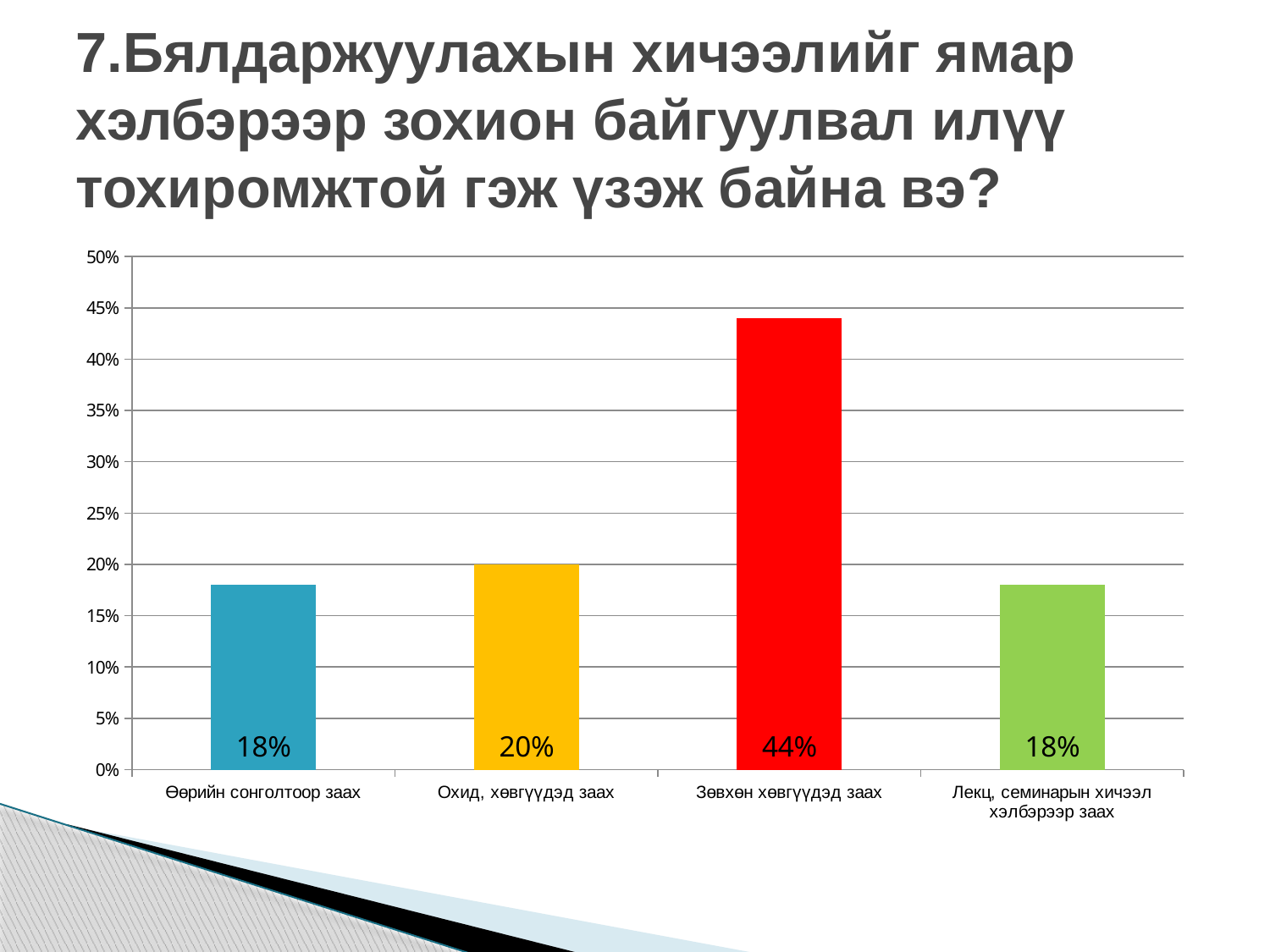
What is the value for Лекц, семинарын хичээл хэлбэрээр заах? 18% What is the difference between the values for Охид, хөвгүүдэд заах and Өөрийн сонголтоор заах? 2% What is the value for Охид, хөвгүүдэд заах? 20% What is the value for Өөрийн сонголтоор заах? 18% Which category has the highest value? Зөвхөн хөвгүүдэд заах What is the difference between the values for Зөвхөн хөвгүүдэд заах and Охид, хөвгүүдэд заах? 24% How many categories are shown on the x axis? 4 What is the value for Зөвхөн хөвгүүдэд заах? 44% What colour is the bar for Зөвхөн хөвгүүдэд заах? red Which is larger, the value for Охид, хөвгүүдэд заах or the value for Лекц, семинарын хичээл хэлбэрээр заах? Охид, хөвгүүдэд заах Is the value for Зөвхөн хөвгүүдэд заах greater or less than 40%? greater What kind of chart is shown on the slide? bar chart